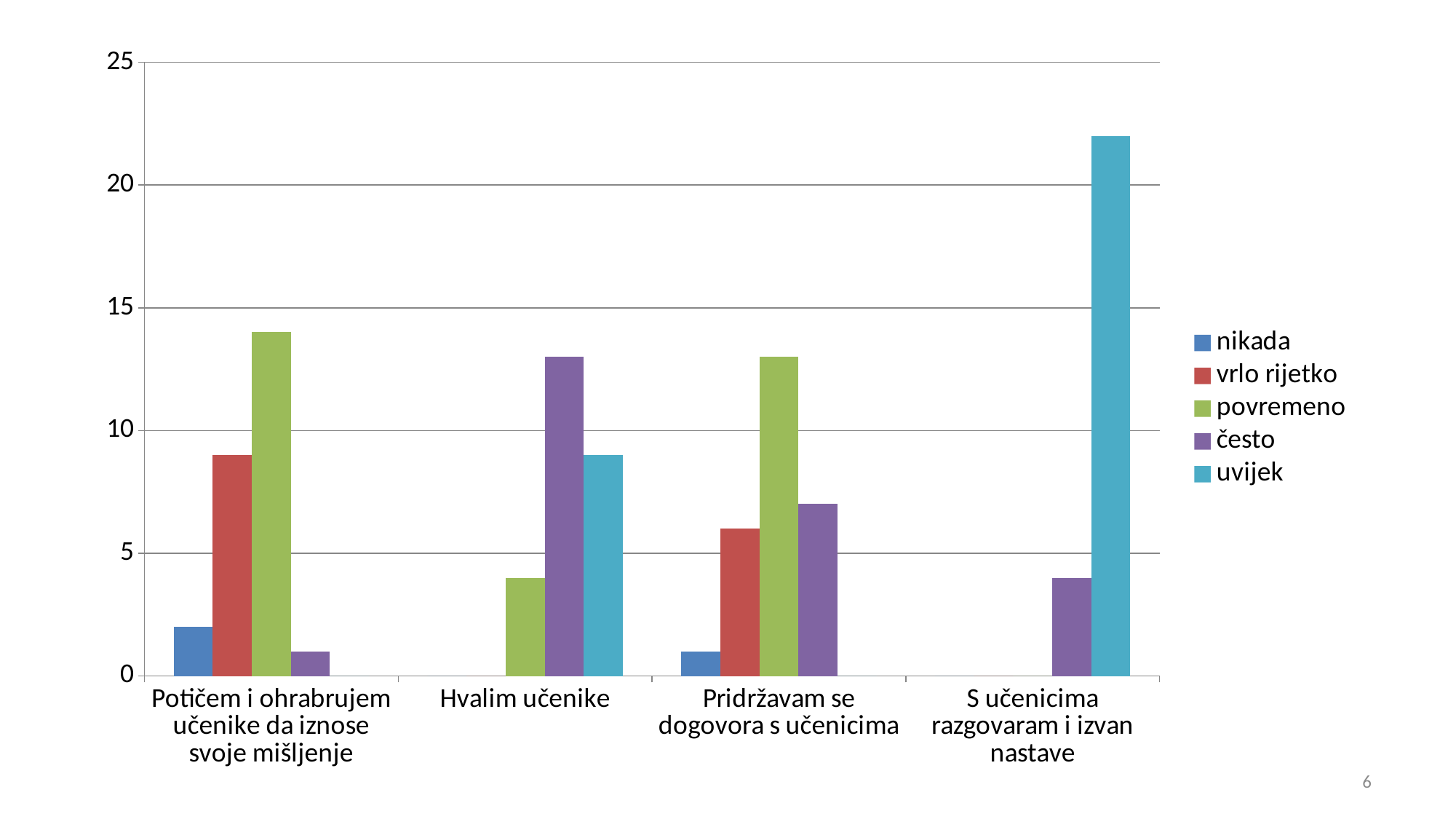
Is the value for 'povremeno' in the category 'Potičem i ohrabrujem učenike da iznose svoje mišljenje' greater or less than 10? greater What is the last entry listed in the legend? uvijek How many categories are shown on the x axis? 4 How many series does the legend list? 5 Is the value for 'često' in the category 'Hvalim učenike' greater or less than 15? less Is the value for 'uvijek' in the category 'S učenicima razgovaram i izvan nastave' greater or less than 20? greater In the category 'Pridržavam se dogovora s učenicima', which is larger: the value for 'povremeno' or the value for 'često'? povremeno Which series has the lowest non-zero bar in the category 'Potičem i ohrabrujem učenike da iznose svoje mišljenje'? često Which series has the tallest bar in the whole chart? uvijek What kind of chart is shown on the slide? bar chart Which series has the highest bar in the category 'Hvalim učenike'? često